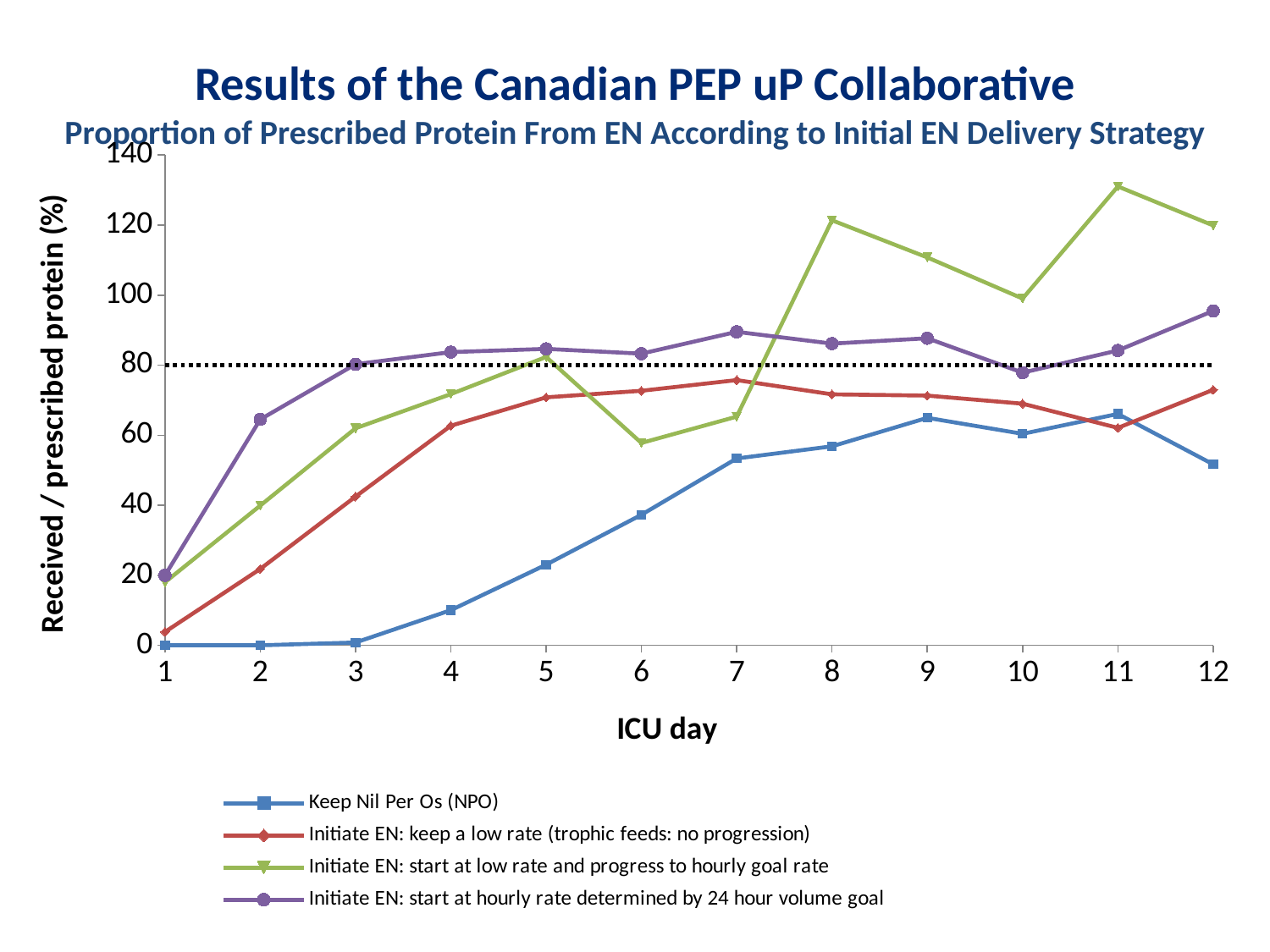
At what value on the y axis is the horizontal dotted reference line drawn? 80 Is the value for 'Keep Nil Per Os (NPO)' on ICU day 12 greater or less than 60? less Which series has the lowest value on ICU day 1? Keep Nil Per Os (NPO) Is the value for 'Initiate EN: start at hourly rate determined by 24 hour volume goal' on ICU day 7 greater or less than 80? greater Is the value for 'Initiate EN: start at low rate and progress to hourly goal rate' on ICU day 8 greater or less than 100? greater How many ICU days are plotted along the x axis? 12 Which series has the highest value on ICU day 8? Initiate EN: start at low rate and progress to hourly goal rate What kind of chart is shown on the slide? line chart How many series does the legend list? 4 On ICU day 6, which is higher: 'Initiate EN: keep a low rate (trophic feeds: no progression)' or 'Initiate EN: start at low rate and progress to hourly goal rate'? Initiate EN: keep a low rate (trophic feeds: no progression) Does the 'Keep Nil Per Os (NPO)' series rise or fall from ICU day 3 to ICU day 9? rise